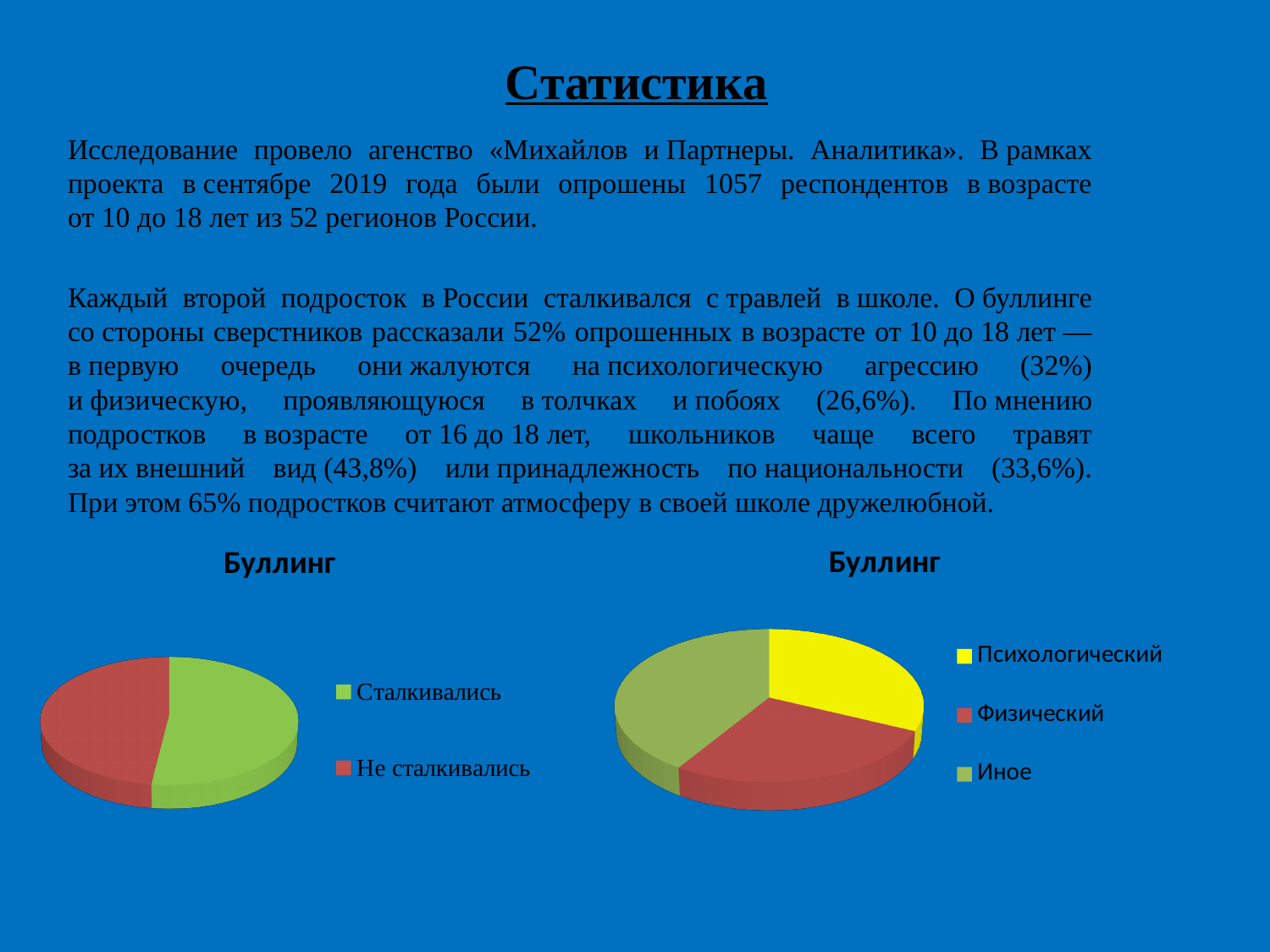
In the right pie chart, which colour represents Психологический? yellow What kind of chart is the left chart on the slide? pie chart In the right pie chart, which slice is larger: Иное or Физический? Иное How many entries does the legend of the right pie chart list? 3 How many slices does the right pie chart have? 3 How many slices does the left pie chart have? 2 In the right pie chart, which category has the largest slice? Иное How many entries does the legend of the left pie chart list? 2 What is the title of the left chart? Буллинг What kind of chart is the right chart on the slide? pie chart